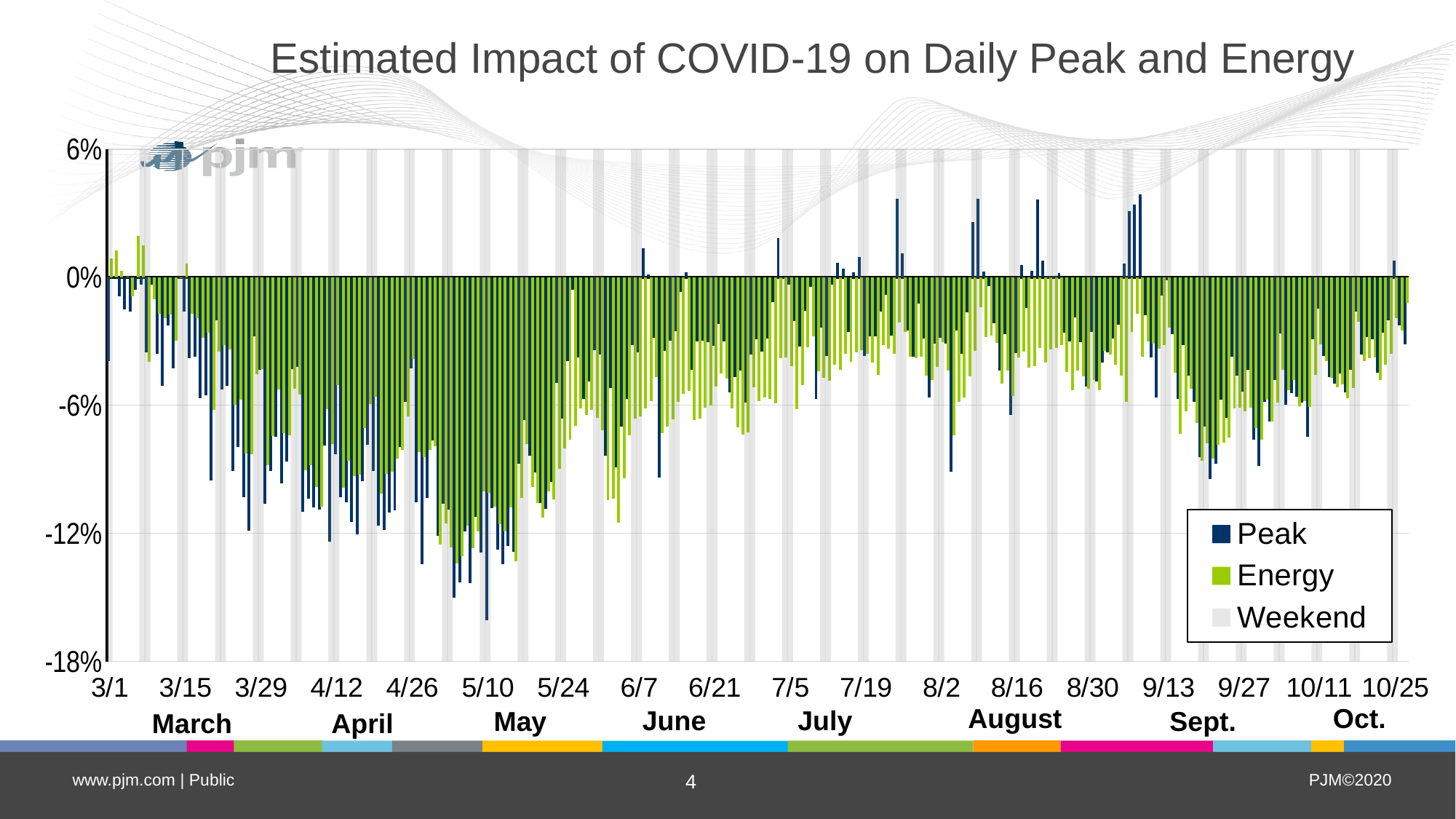
Is the highest Peak value on the chart greater or less than 6%? less What is the title of the chart? Estimated Impact of COVID-19 on Daily Peak and Energy What kind of chart is shown on the slide? bar chart Do the Peak values generally rise or fall from mid-May to early July? rise Is the lowest Energy value on the chart greater or less than -12%? less In which month do the Peak and Energy values reach their lowest point? May Is the lowest Peak value on the chart greater or less than -12%? less How many months are labelled along the x axis? 8 Do the Peak values generally fall or rise from the start of March to mid-May? fall How many entries does the chart legend list? 3 Which legend entry is shown in dark blue? Peak